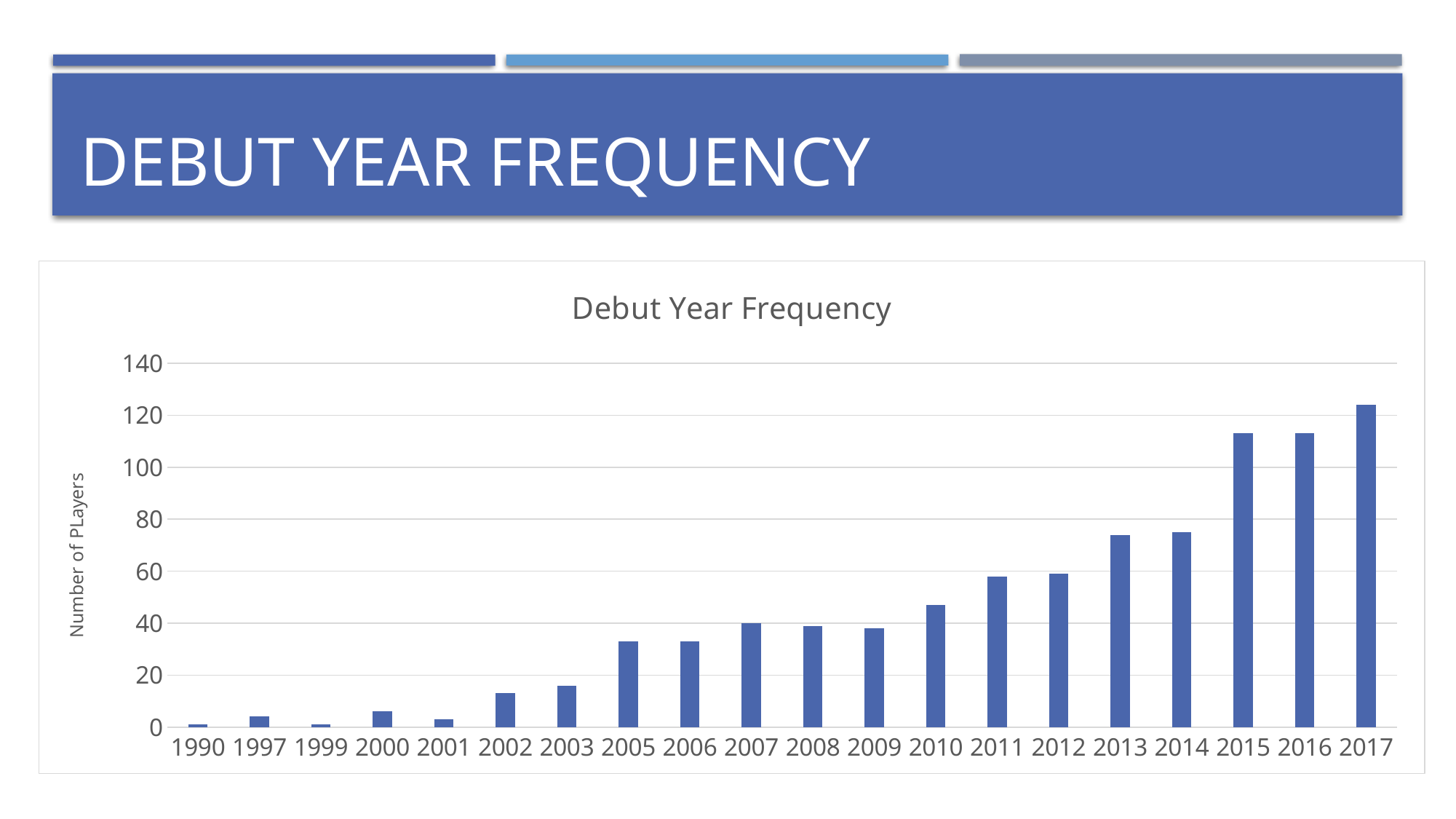
Is the value for 2013 greater or less than 80? less Is the value for 2002 greater or less than 20? less What is the title of the chart? Debut Year Frequency Which debut year has the highest number of players? 2017 Is the value for 2010 greater or less than 40? greater Which has more players, 2013 or 2017? 2017 What is the label on the vertical axis of the chart? Number of PLayers What kind of chart is shown on the slide? bar chart Do the values generally rise or fall from 1990 to 2017 along the x axis? rise How many debut years are shown on the x axis of the chart? 20